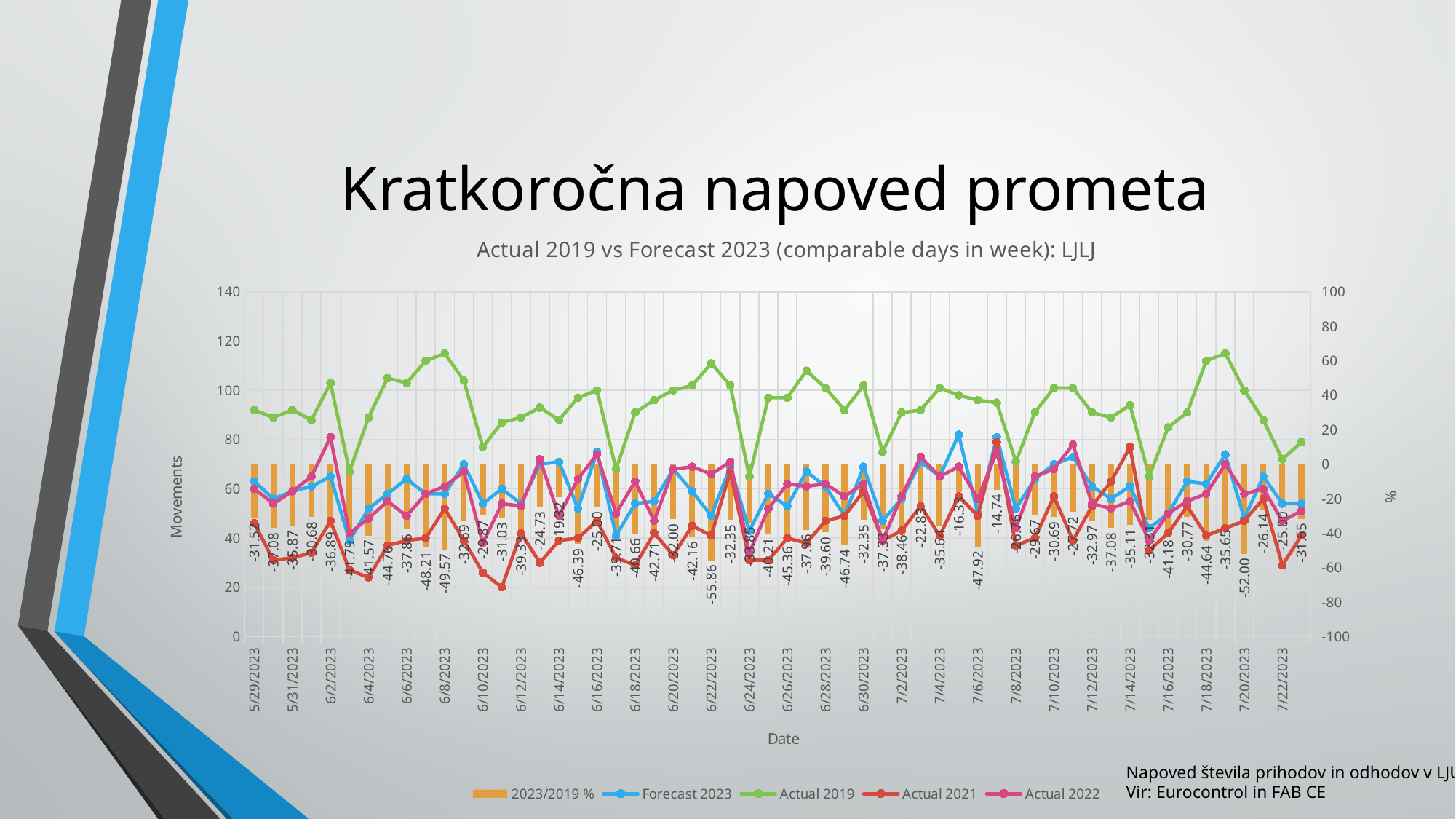
How many series does the legend list? 5 Is the Actual 2019 value for 6/8/2023 greater or less than 100 movements? greater On 6/8/2023, which is larger: Actual 2019 or Actual 2021? Actual 2019 What is the 2023/2019 % value for 6/22/2023? -55.86 What is the lowest 2023/2019 % value shown on the chart? -55.86 Is the Actual 2021 value for 6/10/2023 greater or less than 40 movements? less What is the 2023/2019 % value for 7/20/2023? -52.00 What kind of chart is shown on the slide? A combined bar and line chart What is the title of the chart? Actual 2019 vs Forecast 2023 (comparable days in week): LJLJ What is the highest (least negative) 2023/2019 % value shown on the chart? -14.74 What is the difference between the 2023/2019 % values for 5/29/2023 (-31.52) and 5/31/2023 (-35.87)? 4.35 What is the 2023/2019 % value for 5/29/2023? -31.52